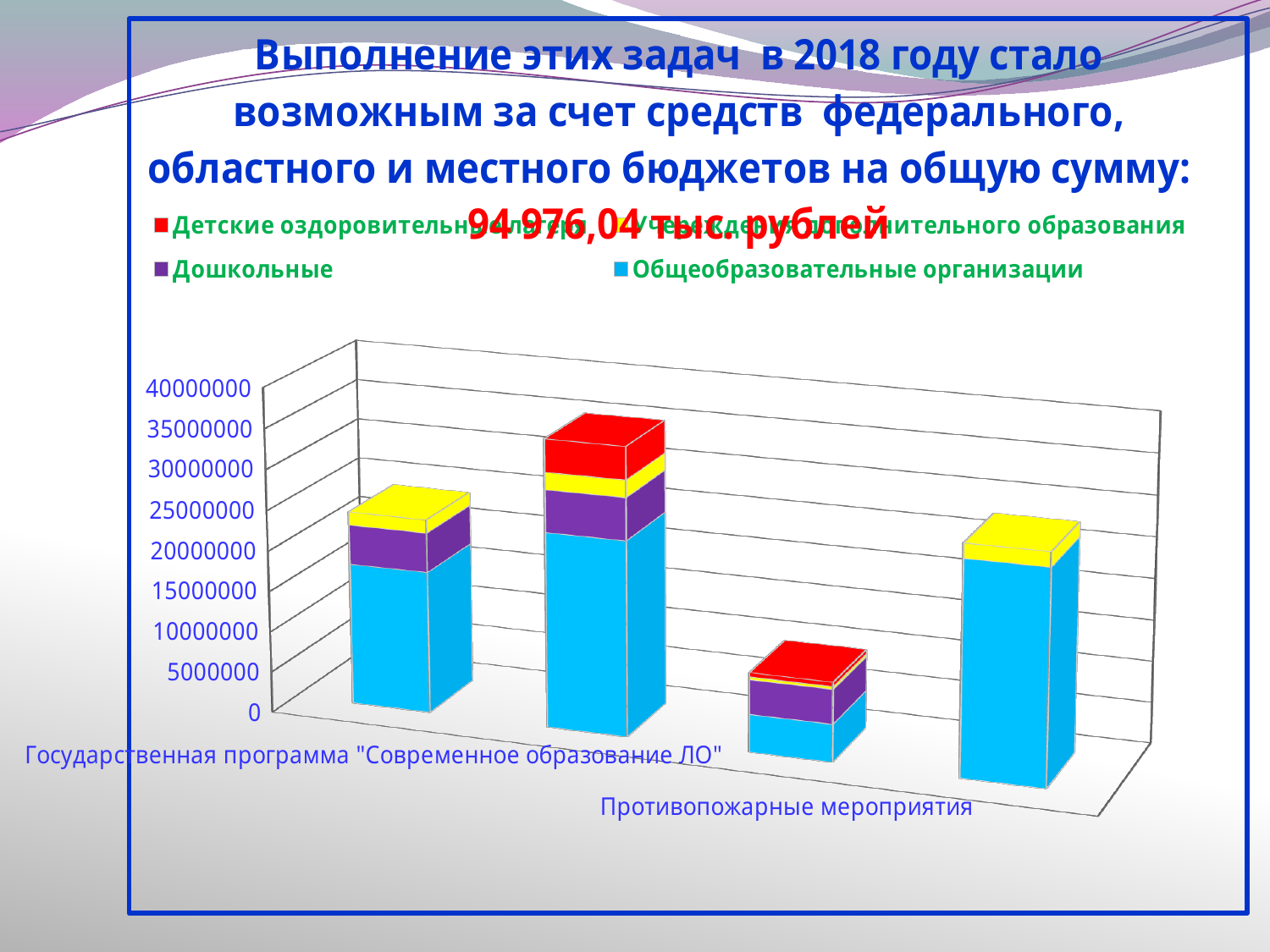
Which series forms the largest segment of the Государственная программа "Современное образование ЛО" bar? Общеобразовательные организации Is the total value for Государственная программа "Современное образование ЛО" greater or less than 20000000? greater Which series is shown in light blue in the legend? Общеобразовательные организации Which bar has the lowest total value? Противопожарные мероприятия Is the total value for Противопожарные мероприятия greater or less than 15000000? less What kind of chart is shown on the slide? A stacked bar chart Is the Общеобразовательные организации segment of the Государственная программа "Современное образование ЛО" bar greater or less than 20000000? less How many series does the legend list? 4 How many bars are plotted in the chart? 4 Which has the larger total value: Государственная программа "Современное образование ЛО" or Противопожарные мероприятия? Государственная программа "Современное образование ЛО" Which series is shown in red in the legend? Детские оздоровительные лагеря Which bar has the highest total value? The second bar from the left